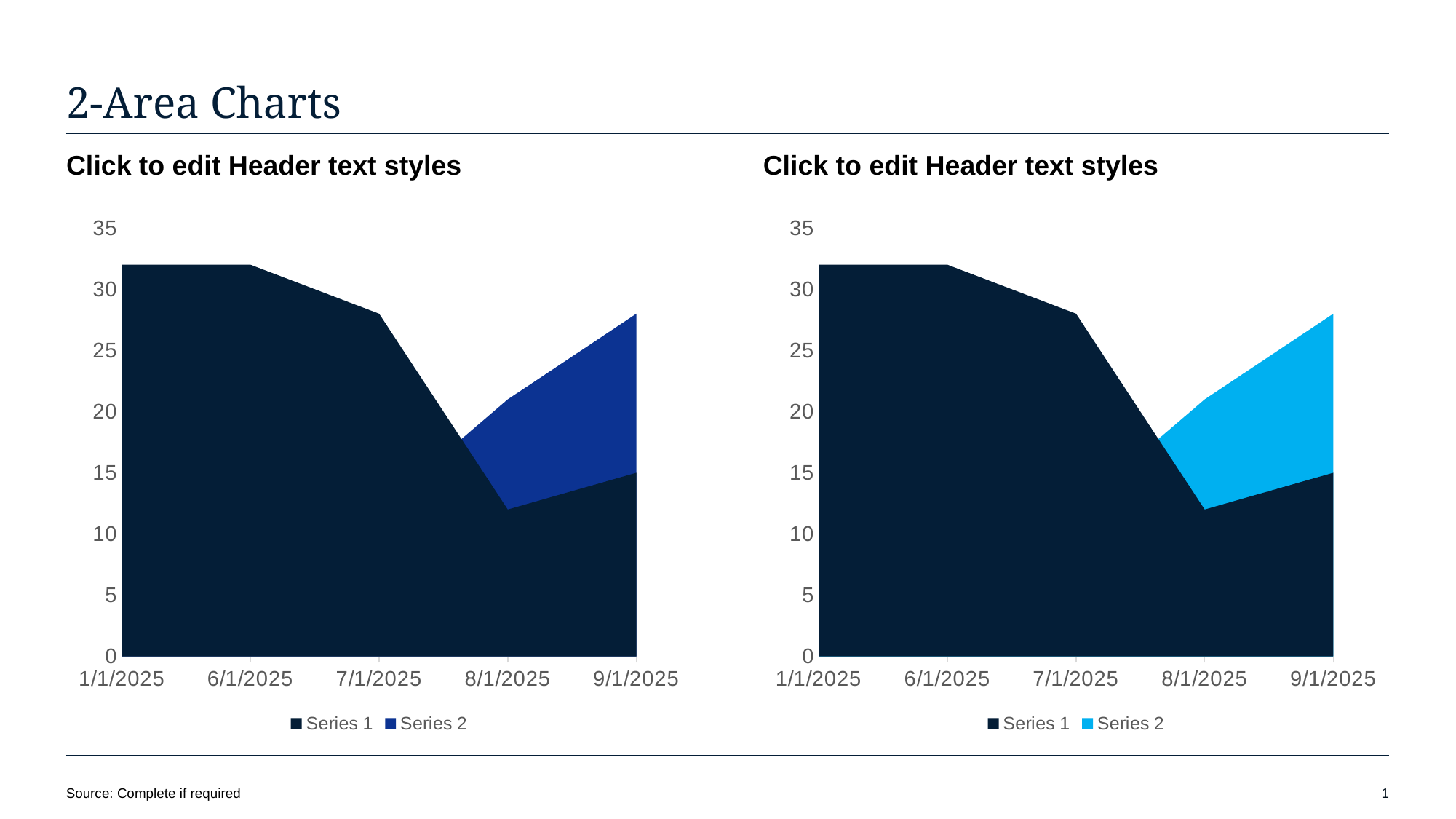
In the right chart, is the value of Series 1 at 8/1/2025 greater or less than 15? less In the left chart, is the value of Series 1 at 1/1/2025 greater or less than 30? greater In the right chart, which is larger for Series 1: the value at 7/1/2025 or at 8/1/2025? 7/1/2025 In the left chart, at which date is Series 1 lowest? 8/1/2025 How many series does the legend of the right chart list? 2 How many dates are shown on the x axis of the left chart? 5 In the left chart, is the value of Series 1 at 7/1/2025 greater or less than 25? greater In the right chart, which is larger at 9/1/2025: Series 1 or Series 2? Series 2 In the left chart, does Series 1 rise or fall from 6/1/2025 to 8/1/2025? fall What is the first date shown on the x axis of the right chart? 1/1/2025 What kind of chart is the left chart? area chart